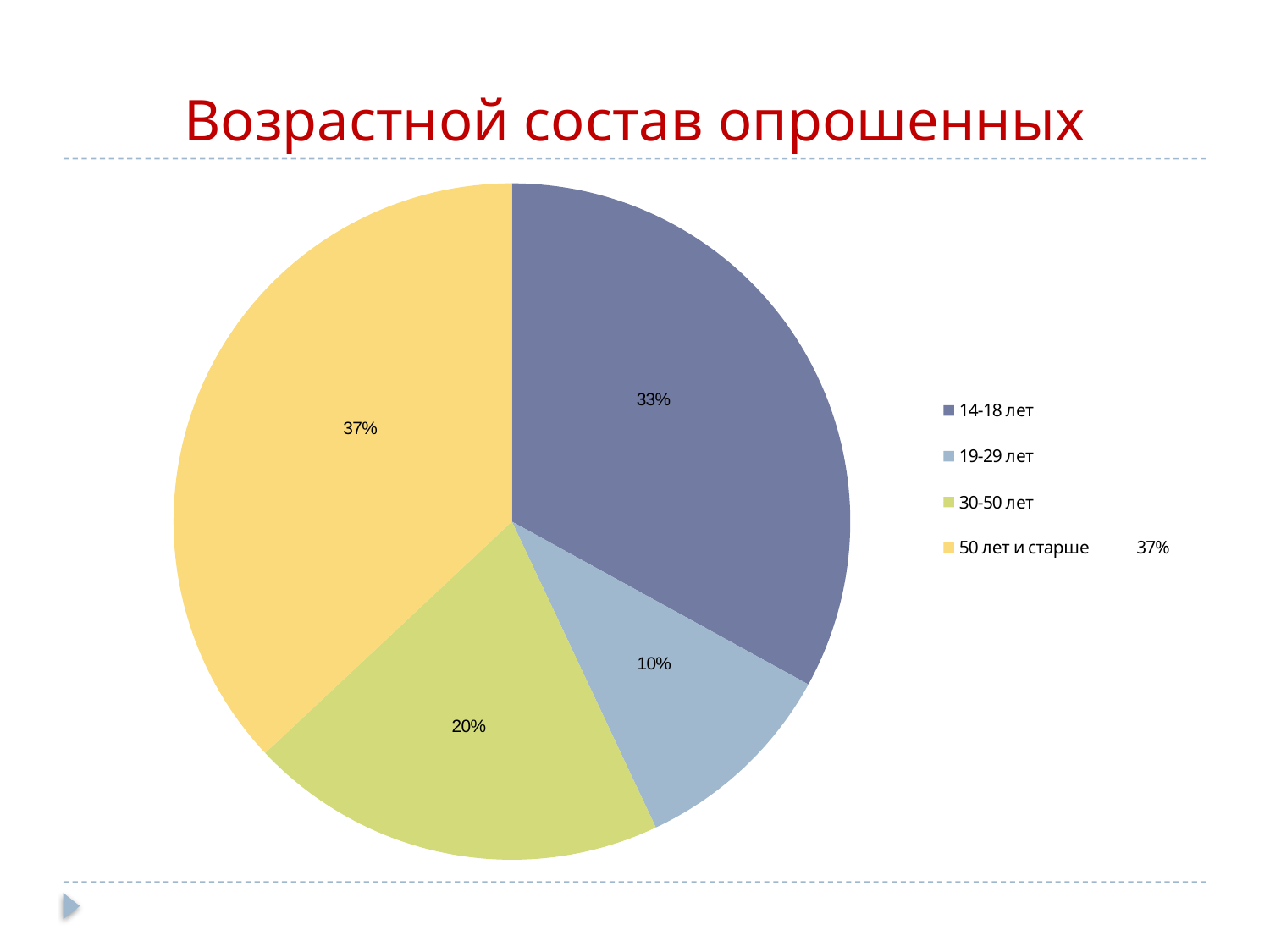
What share of respondents are aged 14-18 лет? 33% What is the difference in percentage points between the 50 лет и старше and 14-18 лет slices? 4 What is the difference in percentage points between the 30-50 лет and 19-29 лет slices? 10 What kind of chart is shown on the slide? Pie chart Which age group has the largest share of respondents? 50 лет и старше What is the title of the chart? Возрастной состав опрошенных What share of respondents are aged 30-50 лет? 20% What share of respondents are aged 19-29 лет? 10% What share of respondents are aged 50 лет и старше? 37% Which age group has the smallest share of respondents? 19-29 лет How many age groups are shown in the pie chart? 4 Which slice is larger: 30-50 лет or 19-29 лет? 30-50 лет